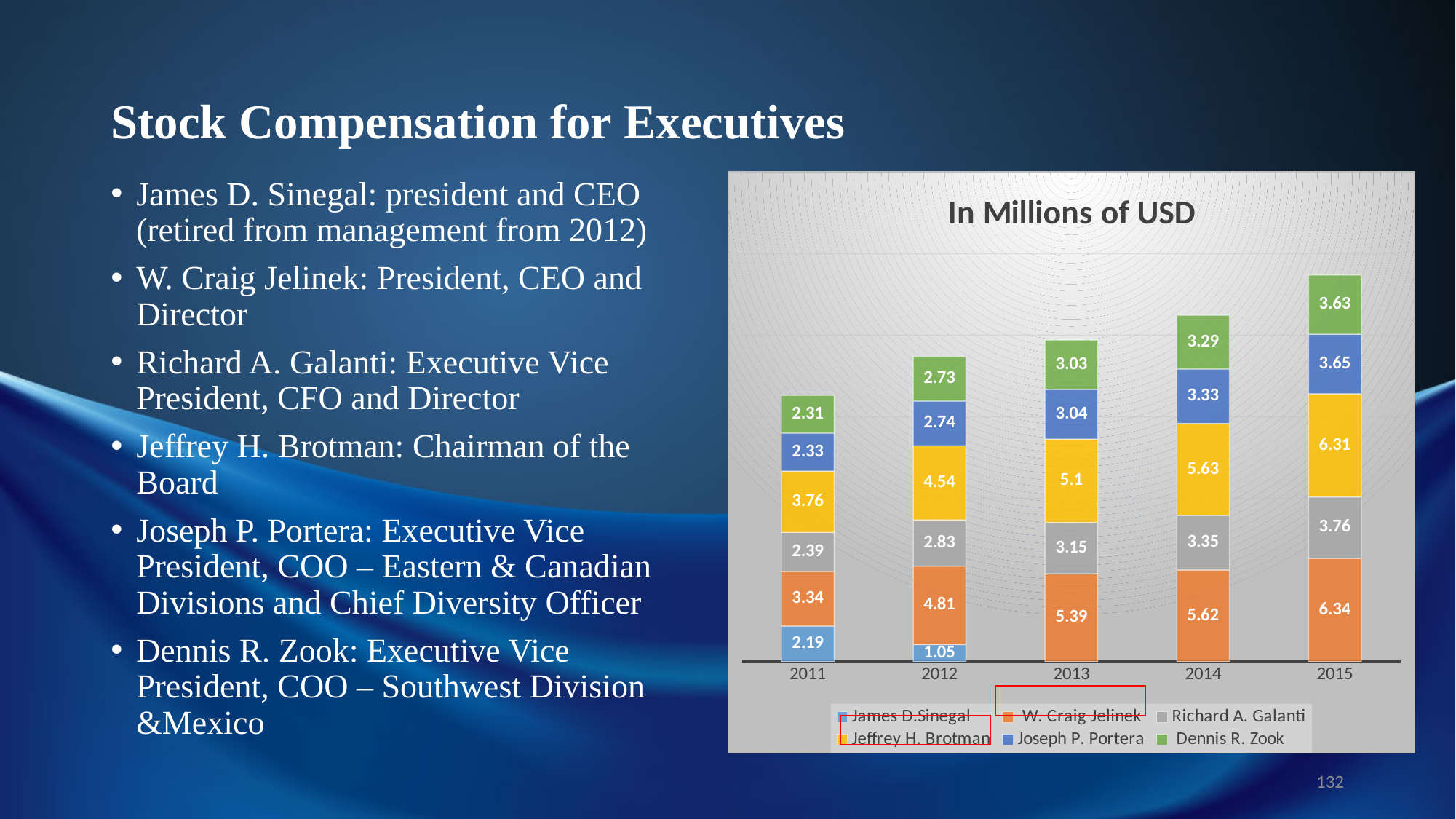
What kind of chart is shown on the slide? Stacked bar chart What is the value for Jeffrey H. Brotman in 2013? 5.1 What is the total of the stacked bar for 2013? 19.71 What is the value for James D. Sinegal in 2012? 1.05 In which year is the value for Richard A. Galanti lowest? 2011 How many series does the chart legend list? 6 How many years are shown on the x axis of the chart? 5 What is the difference between the values for W. Craig Jelinek in 2014 and 2013? 0.23 What is the value for W. Craig Jelinek in 2015? 6.34 Which is larger, the value for Joseph P. Portera in 2012 or the value for Dennis R. Zook in 2012? Joseph P. Portera In which year is the value for Dennis R. Zook highest? 2015 What is the title of the chart? In Millions of USD